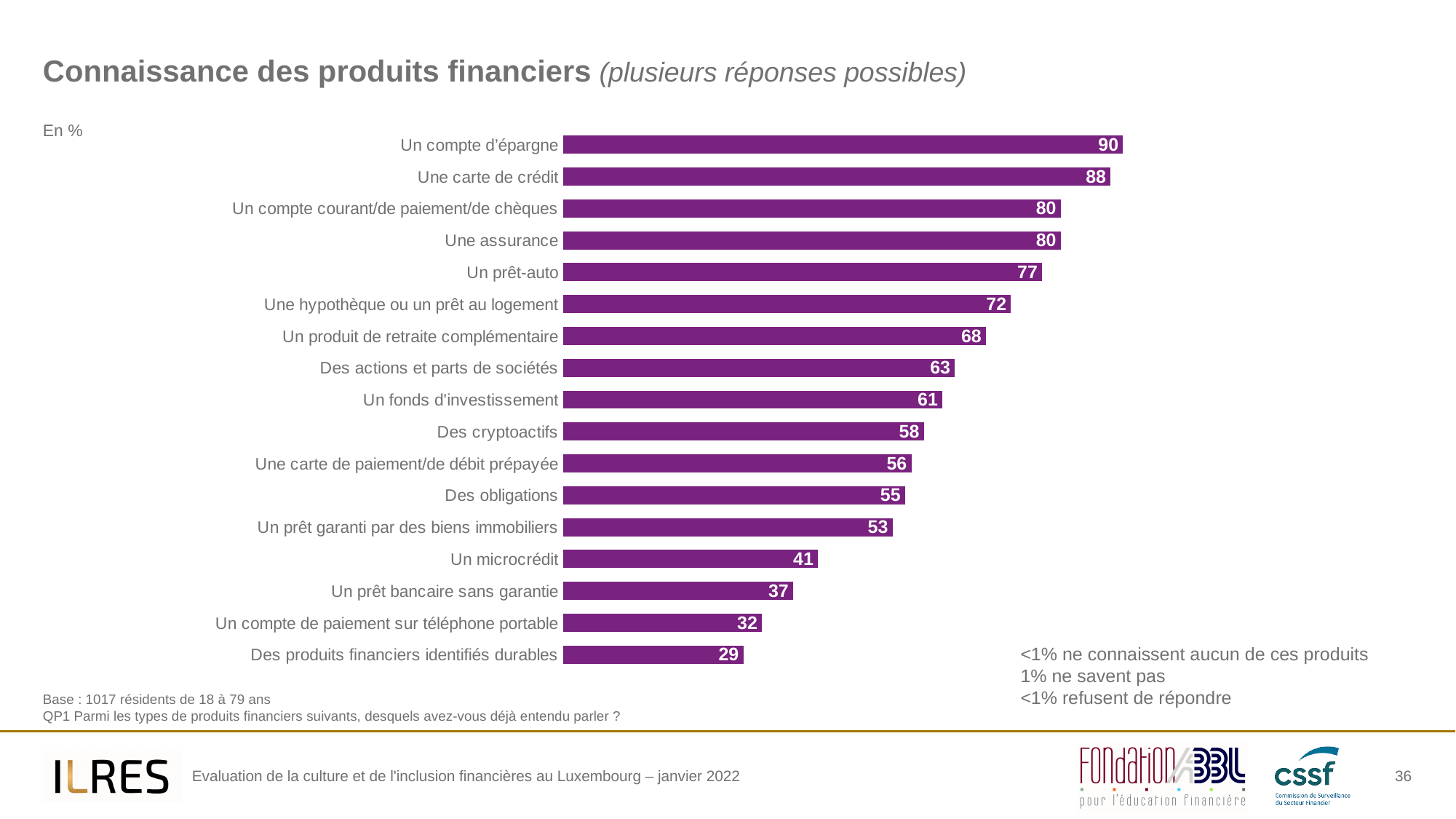
What kind of chart is shown on the slide? Bar chart What is the value for "Une hypothèque ou un prêt au logement"? 72 What is the value for "Des cryptoactifs"? 58 How many categories are shown in the chart? 17 Which is larger: the value for "Des obligations" or the value for "Un prêt bancaire sans garantie"? Des obligations Which category has the highest value? Un compte d'épargne What is the difference between the values for "Un compte d'épargne" and "Des produits financiers identifiés durables"? 61 Which category has the lowest value? Des produits financiers identifiés durables What is the difference between the values for "Une carte de crédit" and "Un prêt-auto"? 11 What is the value for "Un compte d'épargne"? 90 What is the value for "Un microcrédit"? 41 What unit are the values in the chart expressed in, according to the slide? %